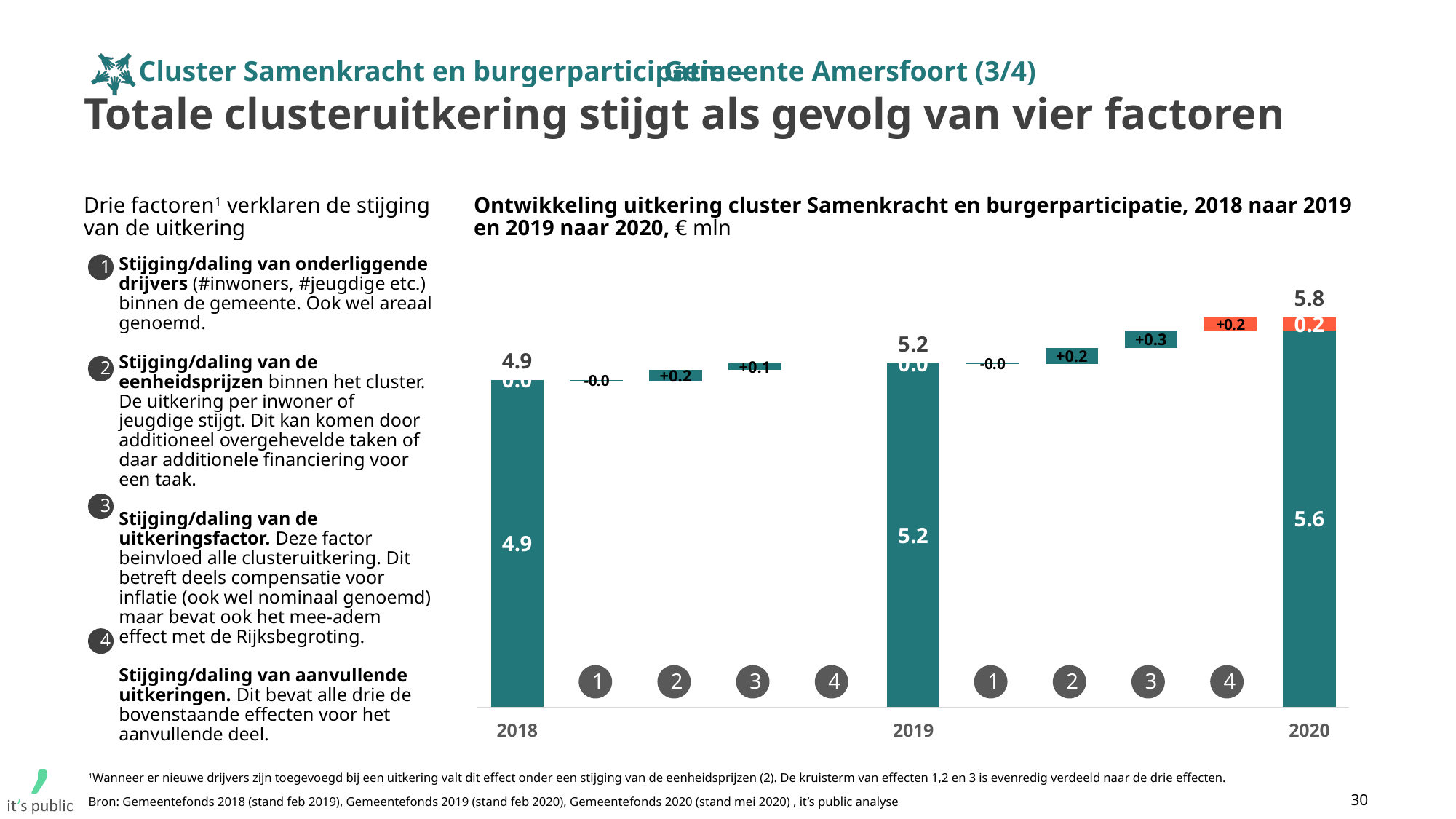
Which year has the highest total payout? 2020 What kind of chart is shown? bar chart (waterfall) What is the total cluster payout shown for 2020? 5.8 What is the effect of factor 2 (eenheidsprijzen) from 2018 to 2019? +0.2 What is the total cluster payout shown for 2018? 4.9 In what unit are the values in the chart expressed? € mln What is the total cluster payout shown for 2019? 5.2 What is the value of the orange segment on top of the 2020 bar? 0.2 What is the difference between the 2020 total and the 2018 total? 0.9 What is the effect of factor 3 (uitkeringsfactor) from 2019 to 2020? +0.3 Which year has the lowest total payout? 2018 Do the total payouts rise or fall from 2018 to 2020? rise